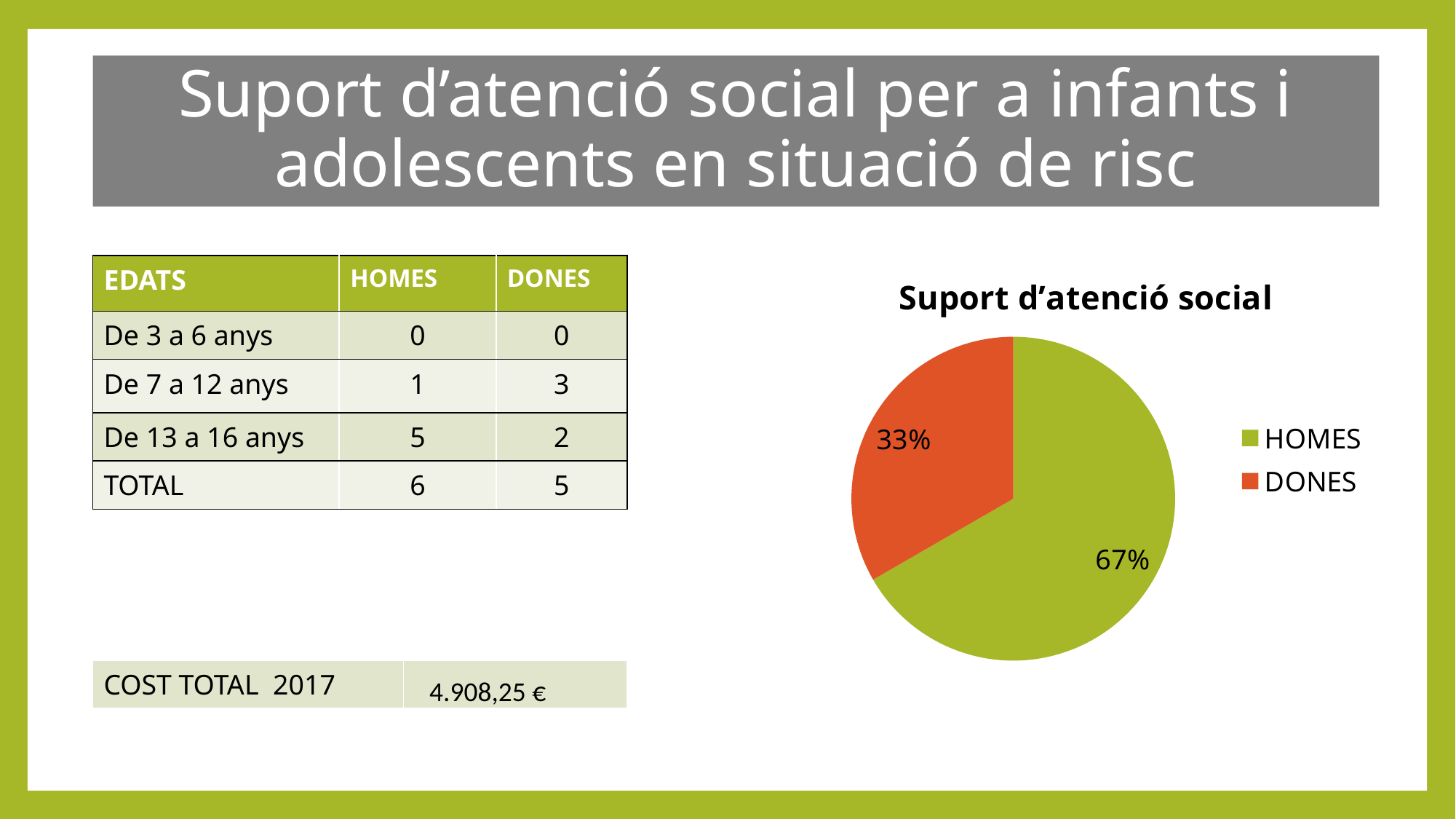
How many entries does the chart legend list? 2 What is the title of the chart? Suport d'atenció social Which slice of the pie chart is the smallest? DONES What share of the pie does DONES represent? 33% What share of the pie does HOMES represent? 67% How many slices does the pie chart have? 2 What is the difference in percentage points between the HOMES and DONES slices? 34 Which slice of the pie chart is the largest? HOMES What kind of chart is shown on the slide? pie chart Which is larger in the pie chart, HOMES or DONES? HOMES Which colour represents DONES in the pie chart? orange